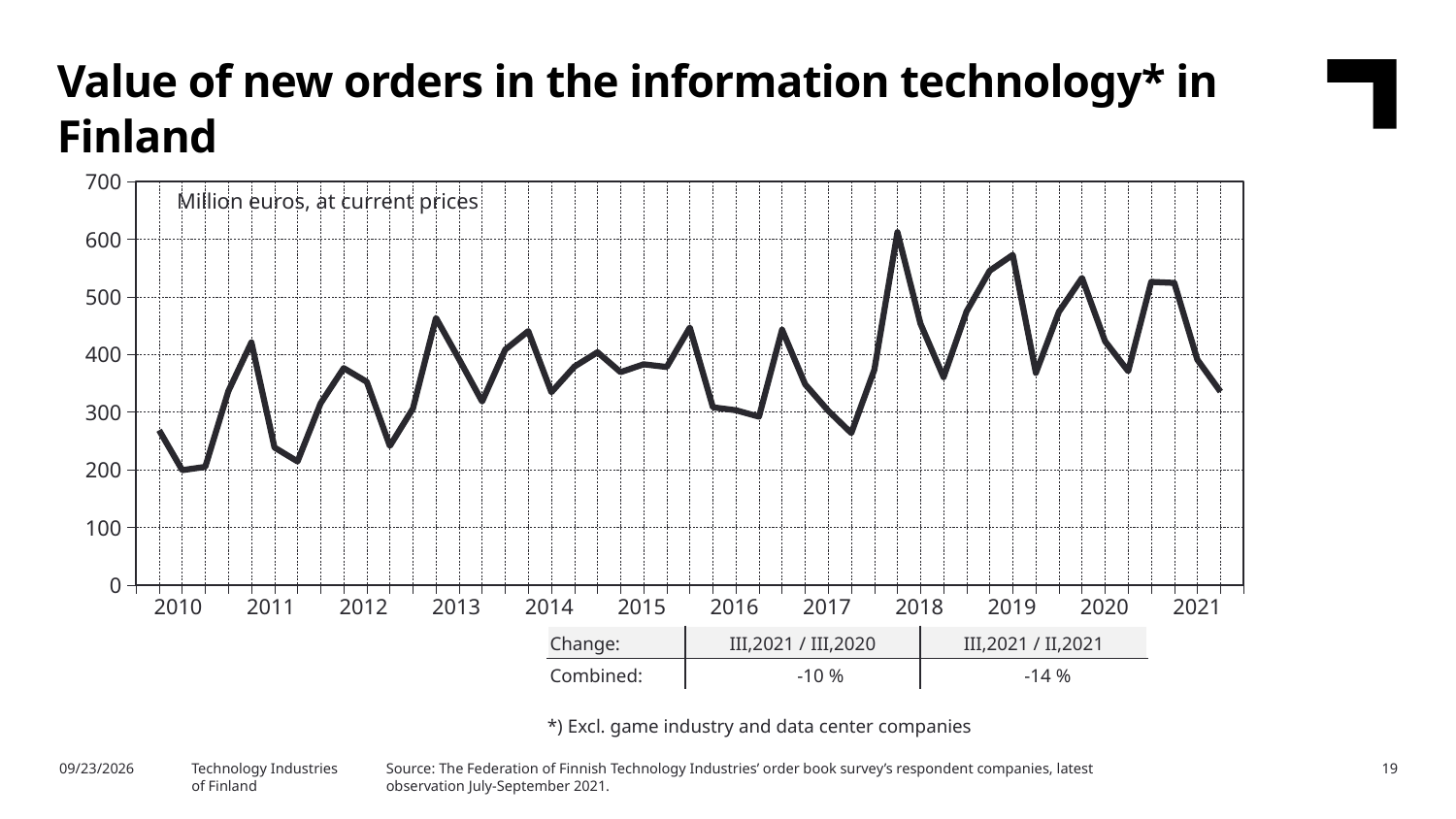
Is the peak of the line in 2013 greater or less than 400? greater In which year does the line reach its highest point? 2018 Does the line rise or fall across the quarters of 2021? fall Is the last plotted value in 2021 greater or less than 400? less Is the highest point of the line in 2018 greater or less than 500? greater Which is higher, the peak of the line in 2018 or the peak in 2013? 2018 What kind of chart is shown on the slide? line chart In what unit are the values on the chart expressed, according to the label inside the plot area? Million euros, at current prices How many years are labelled on the x axis of the chart? 12 What is the title of the chart on the slide? Value of new orders in the information technology* in Finland How many lines are plotted on the chart? 1